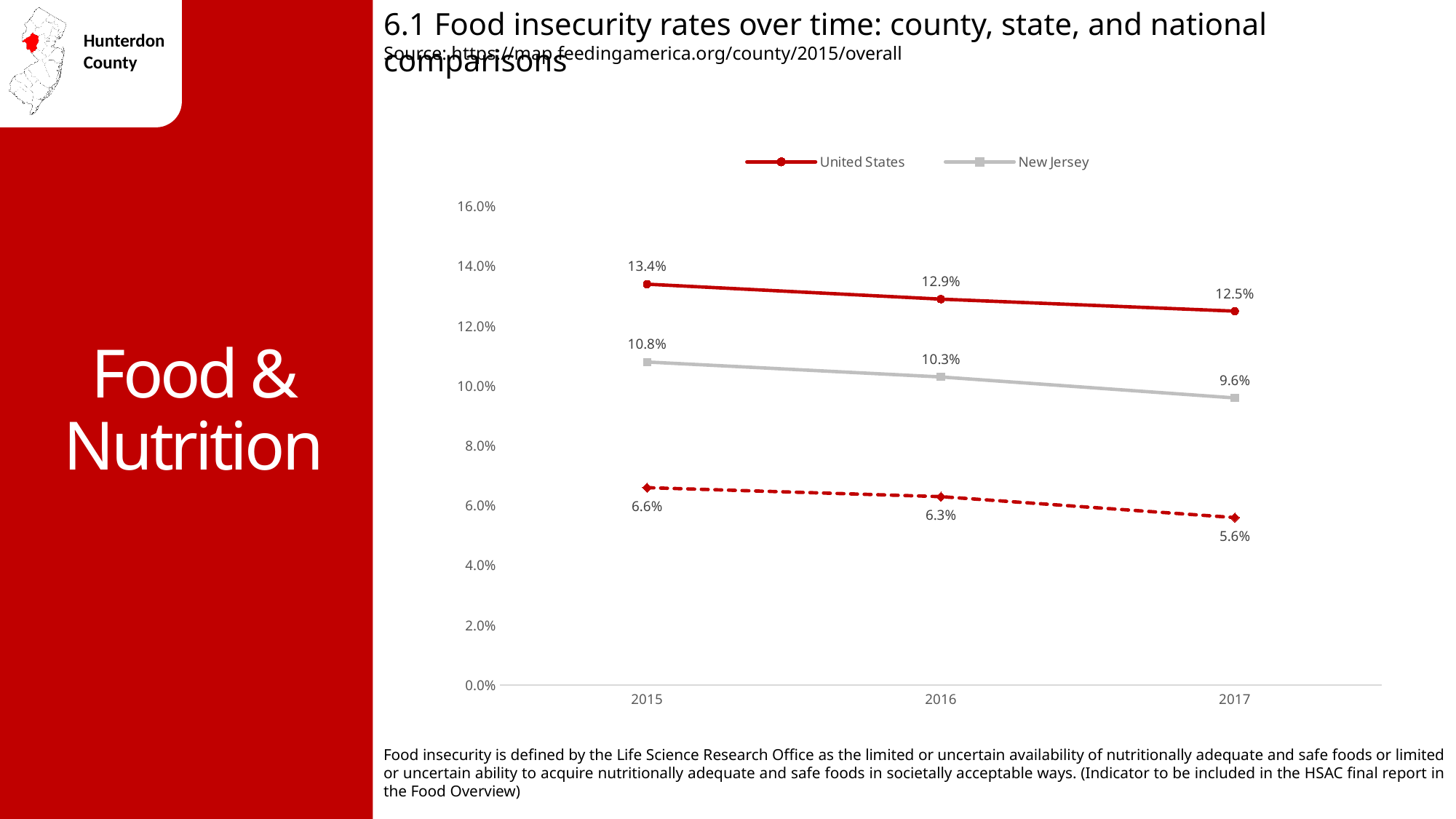
In which year was the New Jersey food insecurity rate highest? 2015 In which year was the United States food insecurity rate lowest? 2017 What is the difference between the United States and New Jersey food insecurity rates in 2015? 2.6% How does the United States food insecurity rate change from 2015 to 2017? It falls What was the food insecurity rate for the United States in 2016? 12.9% How many years are shown on the x axis? 3 What type of chart is shown on the slide? line chart What was the food insecurity rate for New Jersey in 2016? 10.3% How many series does the legend list? 2 Which was higher in 2017, the United States rate or the New Jersey rate? United States What was the food insecurity rate for the United States in 2015? 13.4% What was the food insecurity rate for New Jersey in 2017? 9.6%